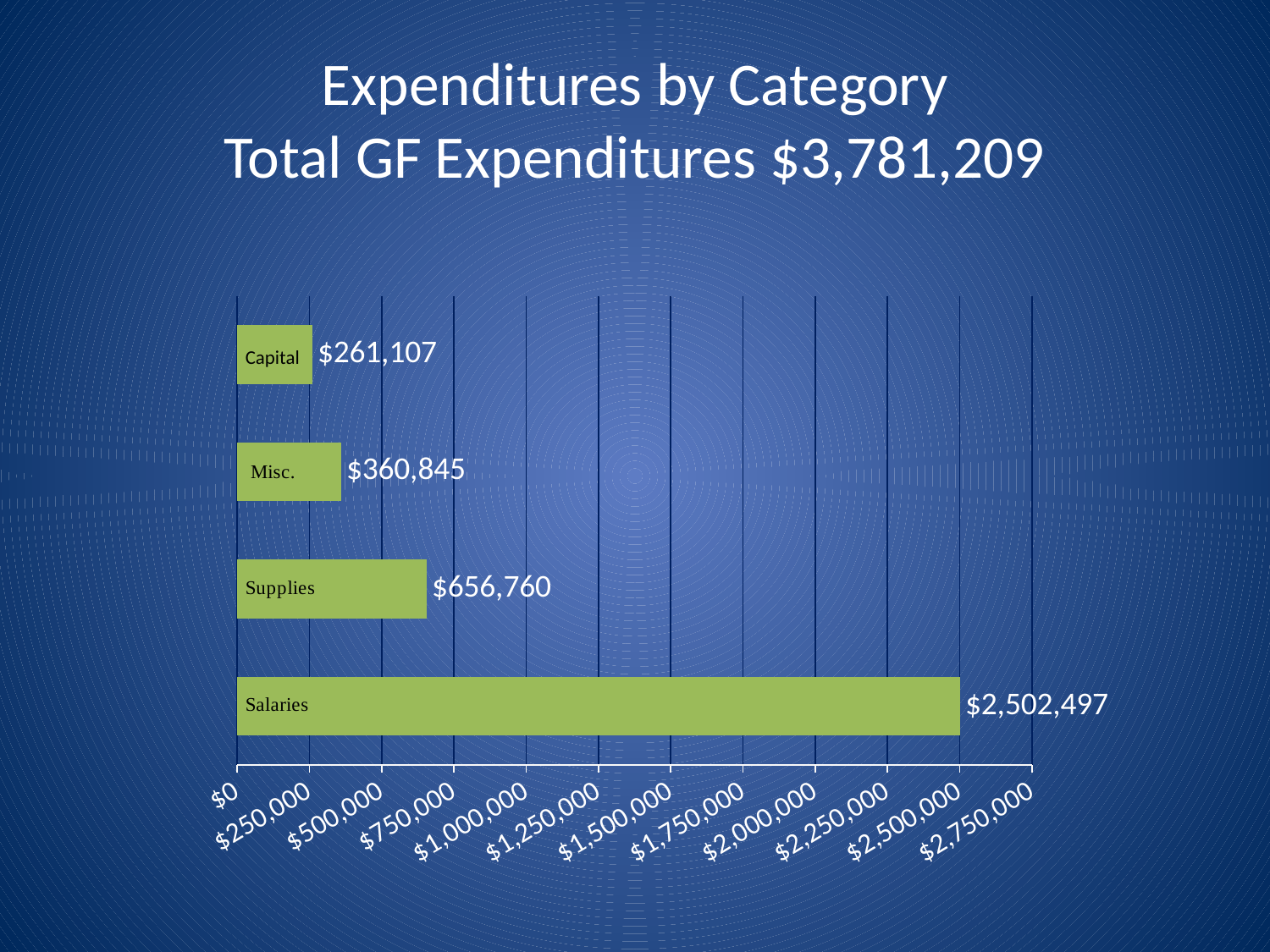
What kind of chart is shown on the slide? Bar chart Which category has the lowest expenditure? Capital Is the value for Supplies greater or less than $500,000? greater Which is larger, Supplies or Misc.? Supplies How many categories are shown in the chart? 4 What is the difference between the Misc. and Capital values? $99,738 What is the value for Capital? $261,107 What is the value for Misc.? $360,845 What is the value for Supplies? $656,760 What is the difference between the Salaries and Supplies values? $1,845,737 What is the value for Salaries? $2,502,497 Which category has the highest expenditure? Salaries